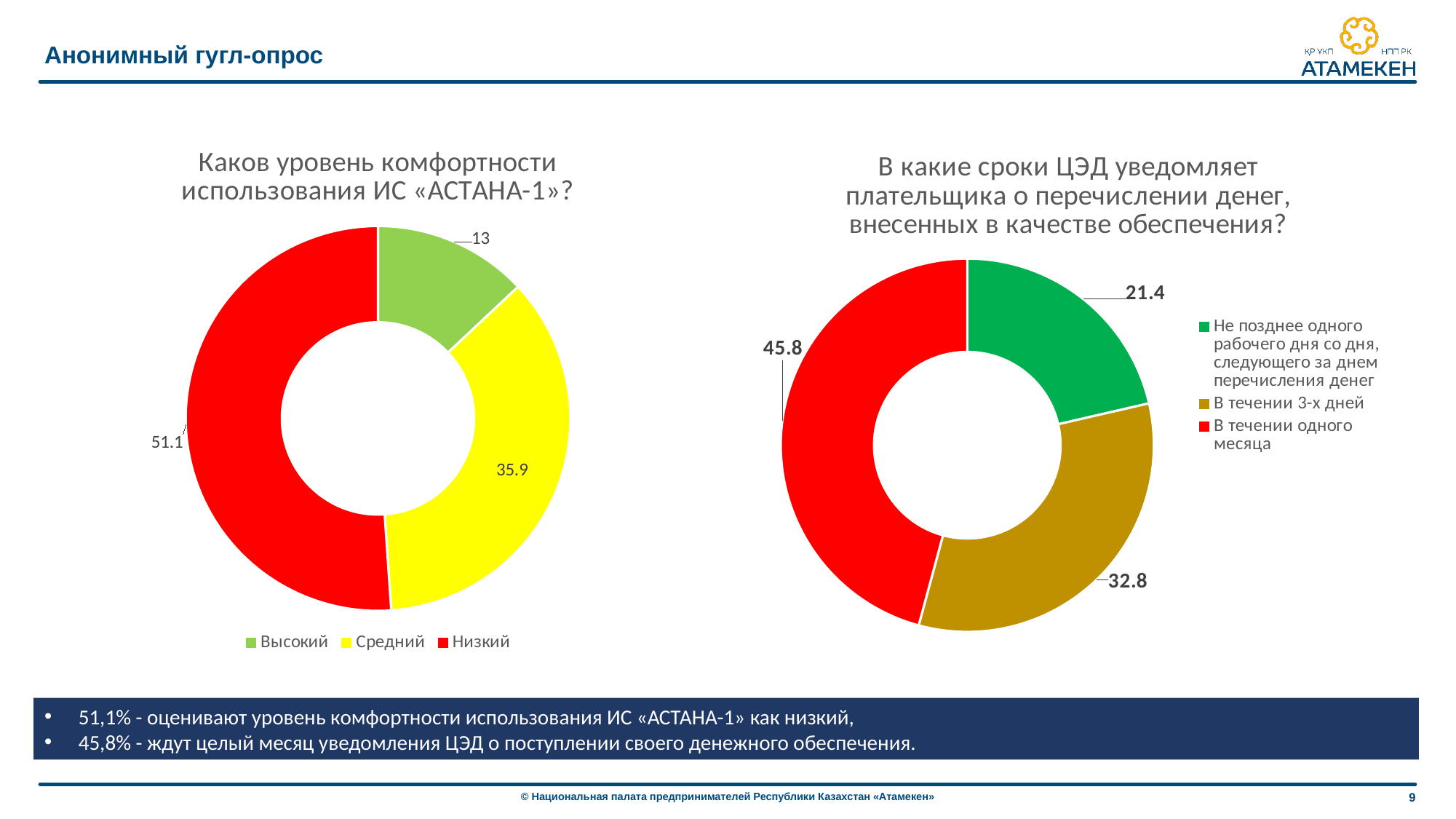
What type of chart is the right chart (В какие сроки ЦЭД уведомляет плательщика...)? Doughnut chart In the left chart (Каков уровень комфортности использования ИС «АСТАНА-1»?), what is the value for Низкий? 51.1 How many categories does the legend of the left chart list? 3 In the left chart (Каков уровень комфортности использования ИС «АСТАНА-1»?), what is the value for Средний? 35.9 In the right chart (В какие сроки ЦЭД уведомляет плательщика...), which category has the smallest share? Не позднее одного рабочего дня со дня, следующего за днем перечисления денег In the left chart (Каков уровень комфортности использования ИС «АСТАНА-1»?), which category has the smallest share? Высокий In the left chart (Каков уровень комфортности использования ИС «АСТАНА-1»?), which category has the largest share? Низкий In the left chart (Каков уровень комфортности использования ИС «АСТАНА-1»?), what is the difference between the values for Низкий and Средний? 15.2 In the right chart (В какие сроки ЦЭД уведомляет плательщика...), which is larger: В течении 3-х дней or В течении одного месяца? В течении одного месяца In the right chart (В какие сроки ЦЭД уведомляет плательщика...), what is the value for В течении 3-х дней? 32.8 In the left chart (Каков уровень комфортности использования ИС «АСТАНА-1»?), what is the value for Высокий? 13 In the right chart (В какие сроки ЦЭД уведомляет плательщика...), what is the value for В течении одного месяца? 45.8